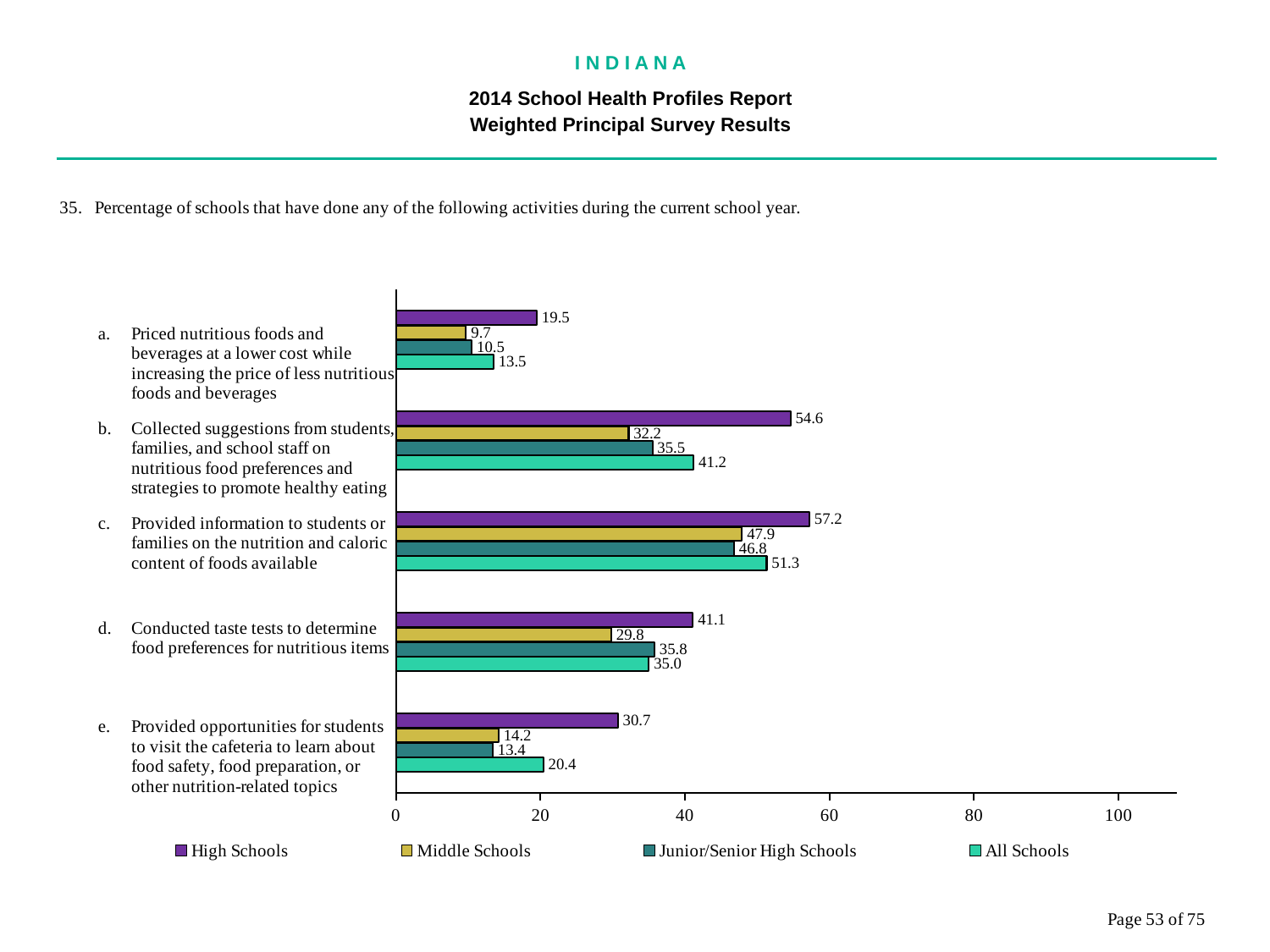
What is the difference between the High Schools and Middle Schools values for activity b, collected suggestions from students, families, and school staff? 22.4 For activity d, conducted taste tests, which is larger: the Middle Schools value or the All Schools value? All Schools Which series is shown in purple in the legend? High Schools What kind of chart is shown on the slide? Bar chart Which activity has the lowest value for All Schools? a. Priced nutritious foods and beverages at a lower cost while increasing the price of less nutritious foods and beverages Which activity has the highest value for High Schools? c. Provided information to students or families on the nutrition and caloric content of foods available How many series does the legend list? 4 What is the value for All Schools for activity e, provided opportunities for students to visit the cafeteria? 20.4 What is the value for High Schools for activity c, provided information to students or families on the nutrition and caloric content of foods available? 57.2 How many activities (categories) are shown on the chart? 5 What is the value for Junior/Senior High Schools for activity d, conducted taste tests to determine food preferences for nutritious items? 35.8 What is the value for Middle Schools for activity a, priced nutritious foods and beverages at a lower cost? 9.7